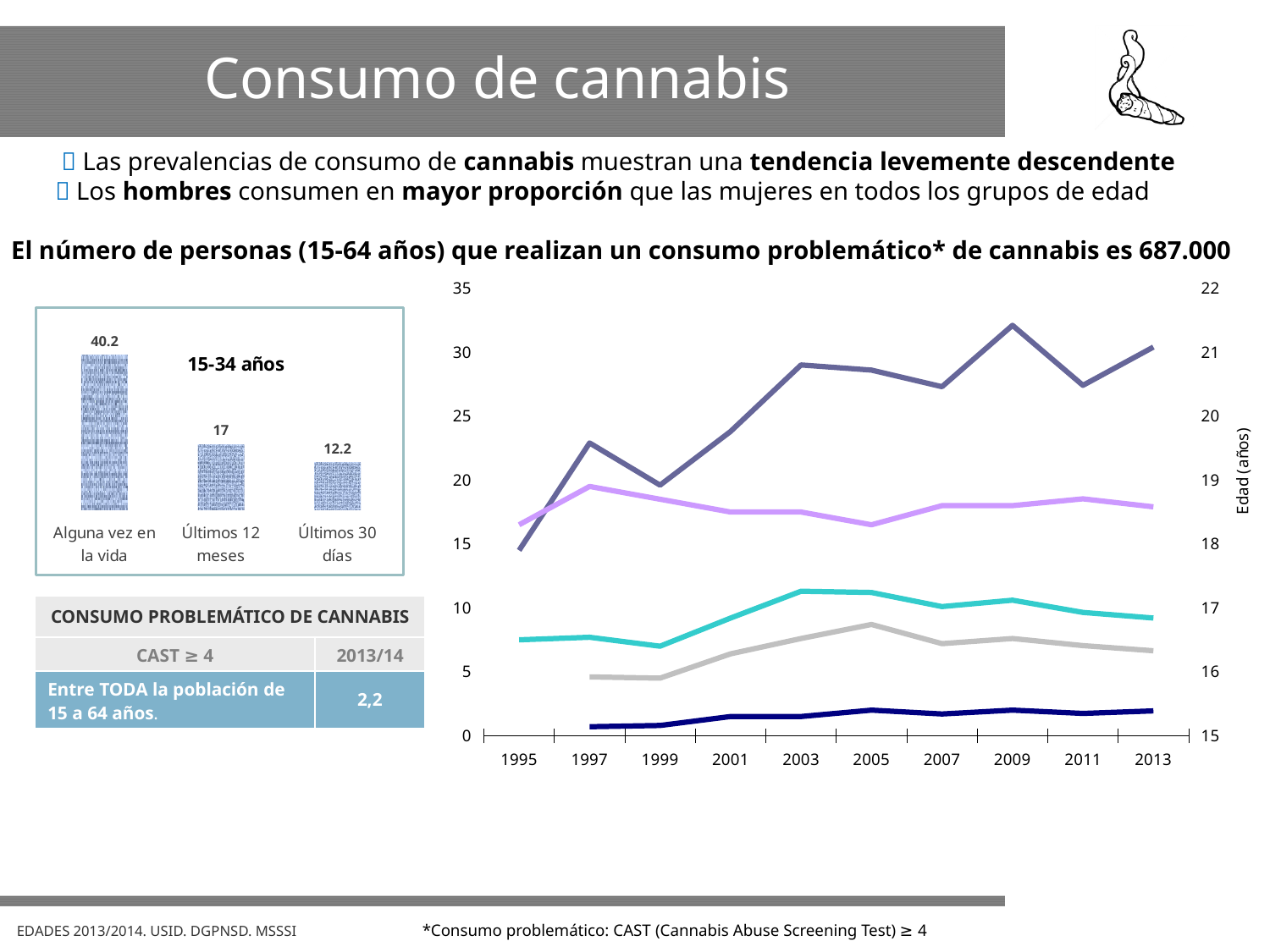
In the bar chart for 15-34 años, what is the value for 'Últimos 12 meses'? 17 What kind of chart is the chart on the left labelled 15-34 años? bar chart What kind of chart is the large chart on the right with years from 1995 to 2013? line chart In the bar chart for 15-34 años, which category has the lowest value? Últimos 30 días In the bar chart for 15-34 años, what is the difference between 'Alguna vez en la vida' and 'Últimos 12 meses'? 23.2 In the bar chart for 15-34 años, which is larger: 'Últimos 12 meses' or 'Últimos 30 días'? Últimos 12 meses In the bar chart for 15-34 años, which category has the highest value? Alguna vez en la vida In the line chart on the right, what is the label of the right-hand vertical axis? Edad (años) How many bars are in the bar chart for 15-34 años? 3 In the bar chart for 15-34 años, what is the difference between 'Últimos 12 meses' and 'Últimos 30 días'? 4.8 In the bar chart for 15-34 años, what is the value for 'Alguna vez en la vida'? 40.2 In the bar chart for 15-34 años, what is the value for 'Últimos 30 días'? 12.2